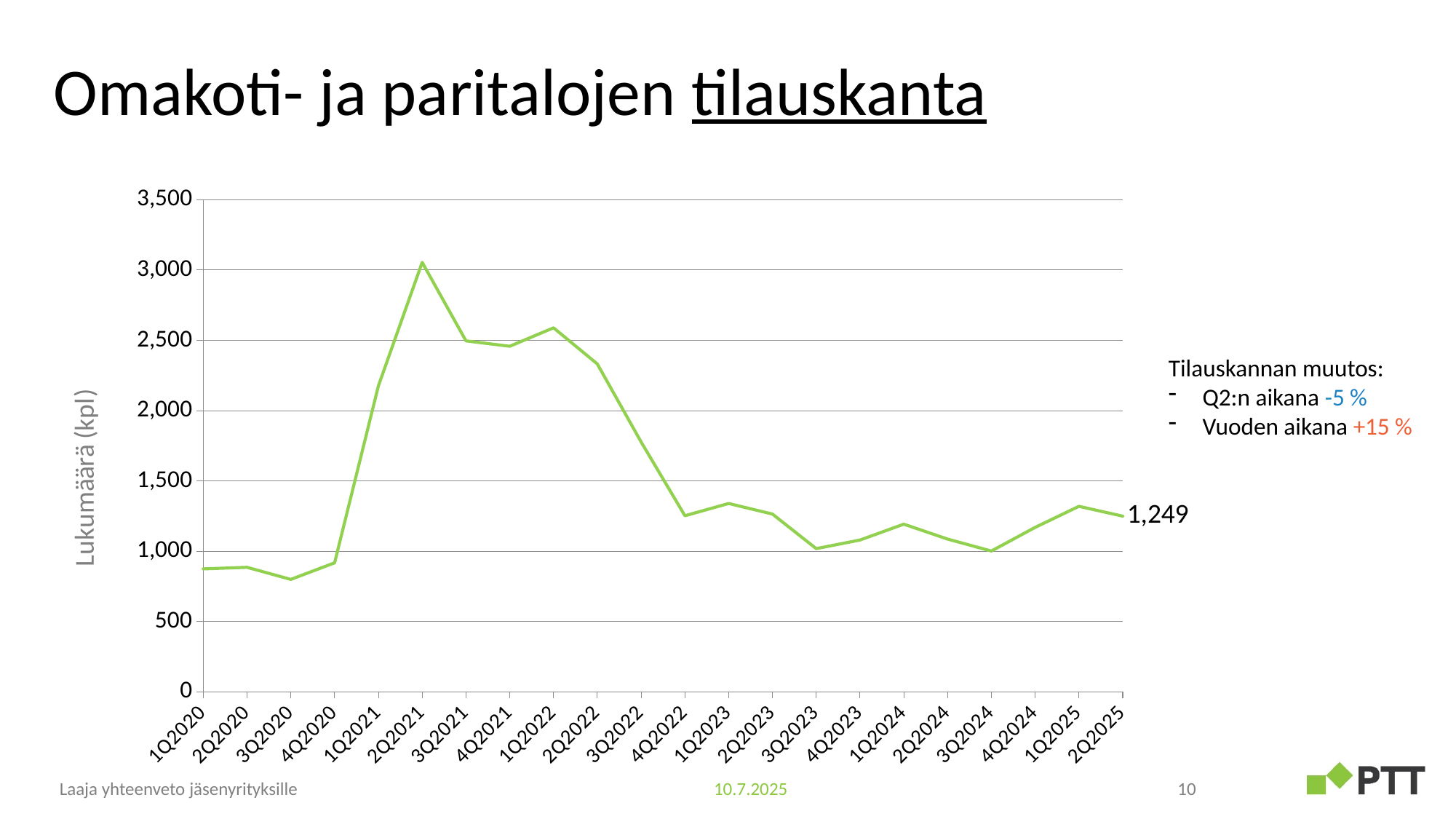
What kind of chart is shown on the slide? line chart Which quarter has the highest value on the chart? 2Q2021 Is the value for 3Q2020 greater or less than 1,000? less Which is larger, the value for 1Q2020 or the value for 4Q2022? 4Q2022 Is the value for 2Q2021 greater or less than 2,500? greater Which is larger, the value for 2Q2021 or the value for 1Q2022? 2Q2021 How many quarters are shown on the x axis of the chart? 22 Is the value for 1Q2025 greater or less than 1,000? greater Do the values rise or fall from 2Q2021 to 4Q2022? fall Which quarter has the lowest value on the chart? 3Q2020 What value is labelled for 2Q2025 on the chart? 1,249